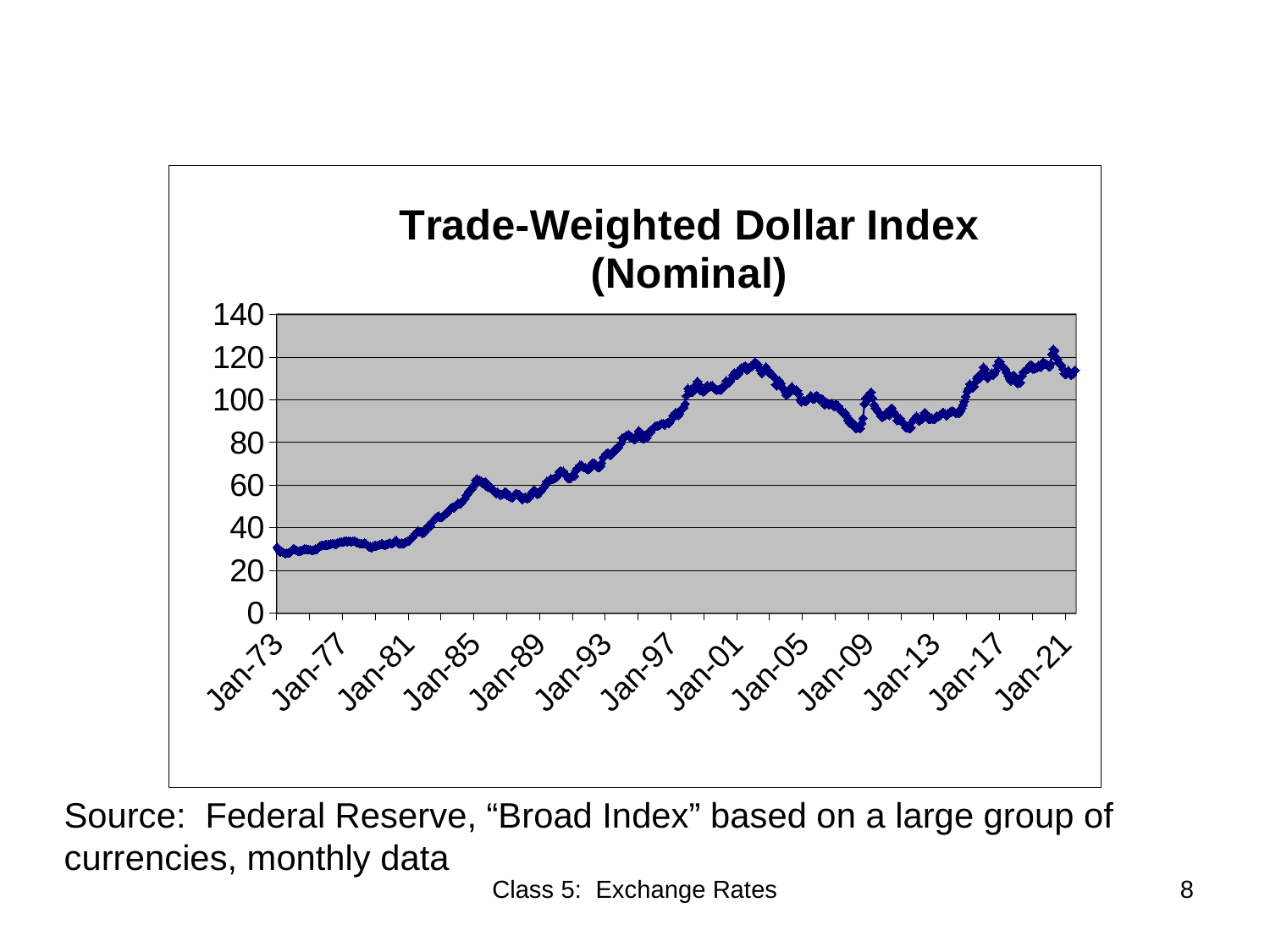
What is the title of the chart? Trade-Weighted Dollar Index (Nominal) Is the value of the index at Jan-01 greater or less than 100? greater Is the value of the index at Jan-93 greater or less than 60? greater Does the index rise or fall between Jan-01 and Jan-09? fall Is the value of the index at Jan-73 greater or less than 40? less How many date labels are shown on the x axis? 13 Overall, does the Trade-Weighted Dollar Index rise or fall from Jan-73 to Jan-21? rise What is the highest value shown on the y axis? 140 What kind of chart is shown on the slide? line chart